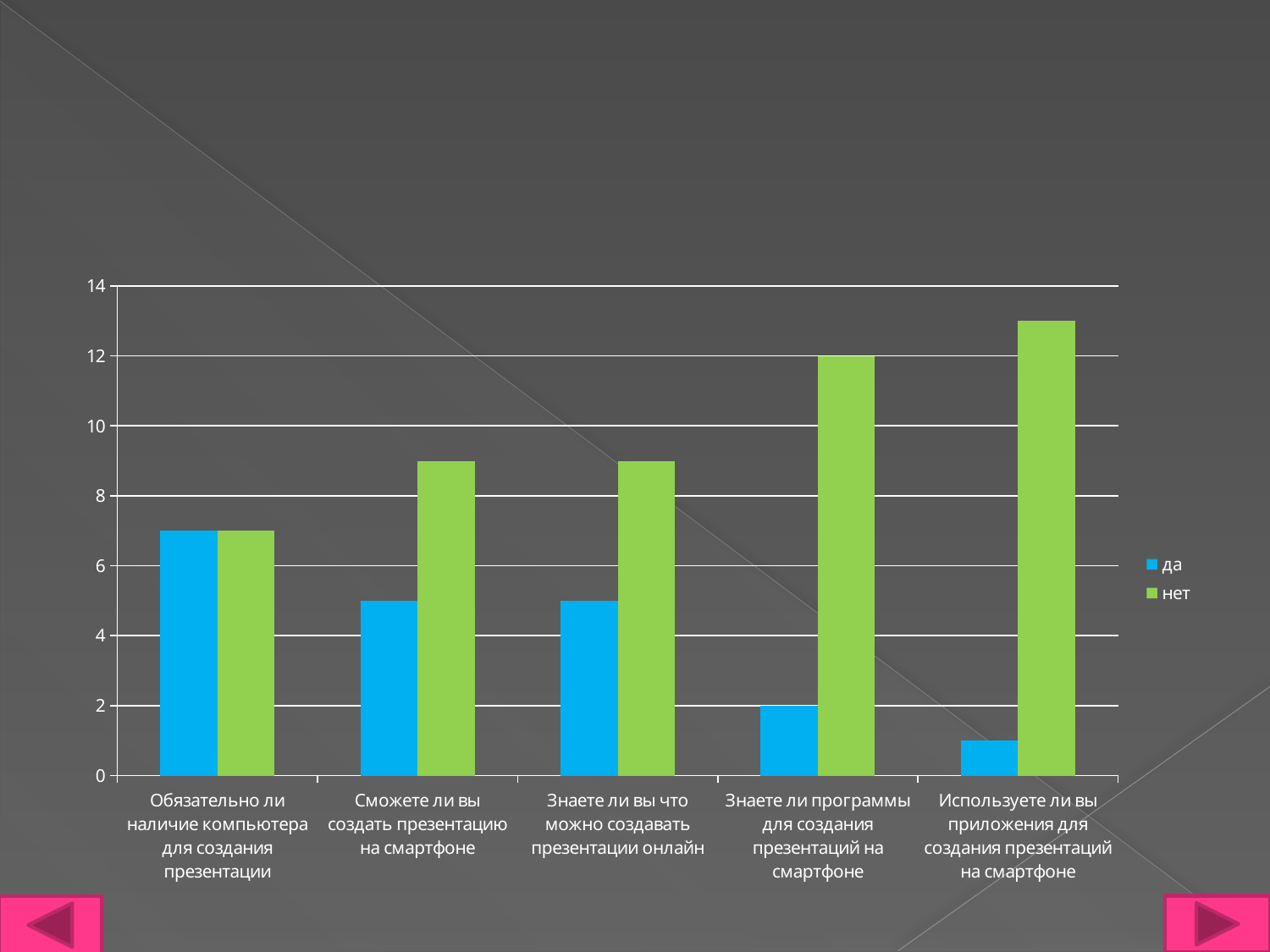
Is the "нет" value for "Используете ли вы приложения для создания презентаций на смартфоне" greater or less than 12? greater Which category has the highest "нет" value? Используете ли вы приложения для создания презентаций на смартфоне What is the value of the "нет" series for "Знаете ли программы для создания презентаций на смартфоне"? 12 What is the difference between the "нет" and "да" values for "Знаете ли программы для создания презентаций на смартфоне"? 10 What kind of chart is shown on the slide? bar chart Is the "да" value for "Сможете ли вы создать презентацию на смартфоне" greater or less than 6? less What is the value of the "да" series for "Знаете ли программы для создания презентаций на смартфоне"? 2 For "Знаете ли вы что можно создавать презентации онлайн", which is larger, the "да" value or the "нет" value? нет How many categories (questions) are shown on the x axis? 5 How many series does the legend list? 2 Which category has the lowest "да" value? Используете ли вы приложения для создания презентаций на смартфоне Which colour represents the "да" series in the legend? blue